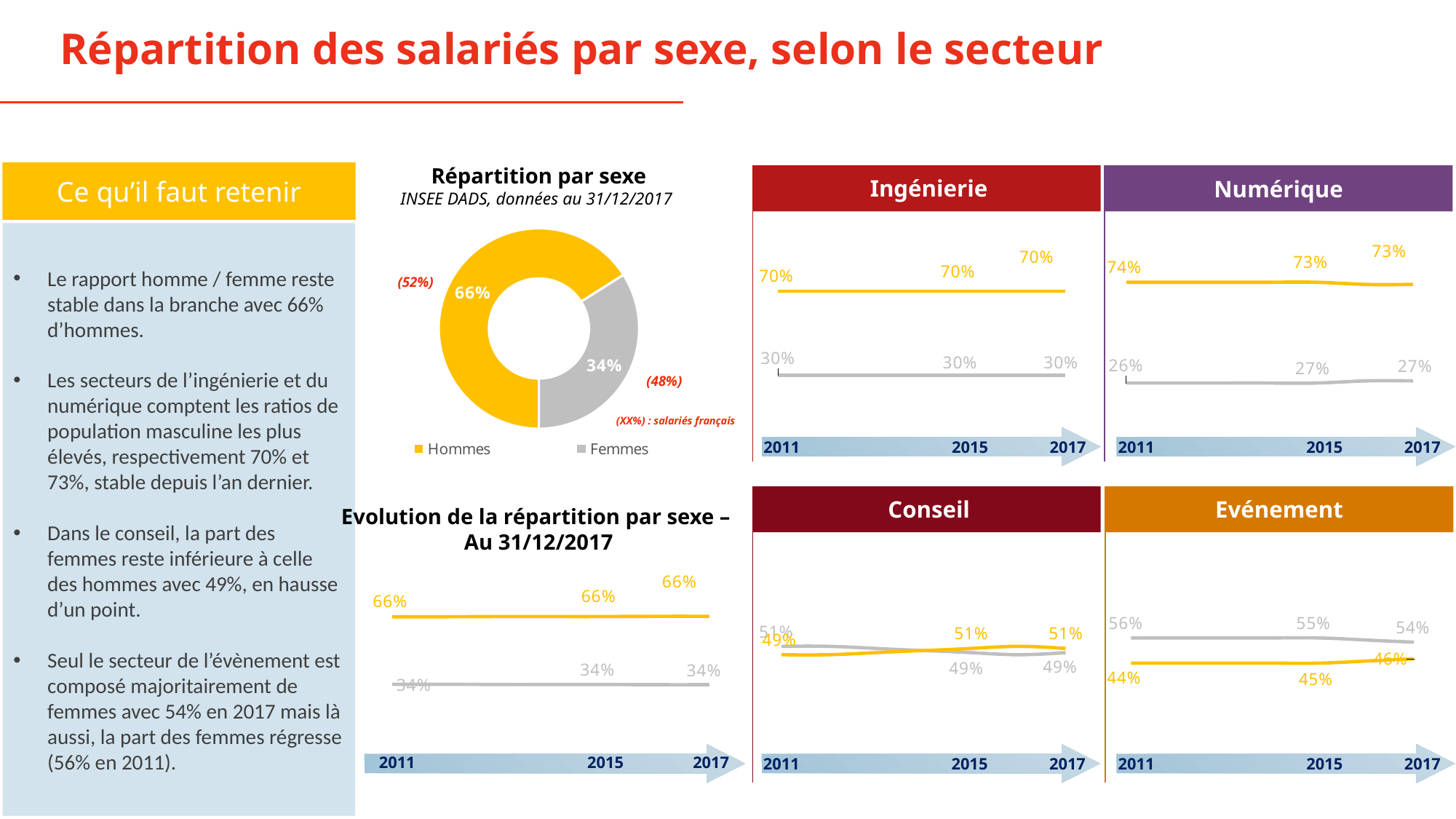
In the 'Répartition par sexe' donut chart, what share is shown for Hommes? 66% What kind of chart is 'Répartition par sexe'? Donut (pie) chart In the 'Répartition par sexe' donut chart, what share is shown for Femmes? 34% In the 'Conseil' chart, which is larger in 2017, the Hommes value or the Femmes value? Hommes (51%) How many time points are shown on the x axis of the 'Evolution de la répartition par sexe' chart? 3 In the 'Evénement' chart, does the yellow (Hommes) line rise or fall from 2011 to 2017? Rises In the 'Evénement' chart, what is the value of the grey (Femmes) line in 2011? 56% How many series does the legend of the 'Répartition par sexe' chart list? 2 In the 'Ingénierie' chart, what is the value of the yellow (Hommes) line in 2017? 70% In the 'Numérique' chart, what is the difference between the Hommes and Femmes values in 2017? 46 percentage points In the 'Evolution de la répartition par sexe' chart, what is the value of the grey (Femmes) line in 2015? 34% In the 'Numérique' chart, what is the value of the yellow (Hommes) line in 2011? 74%